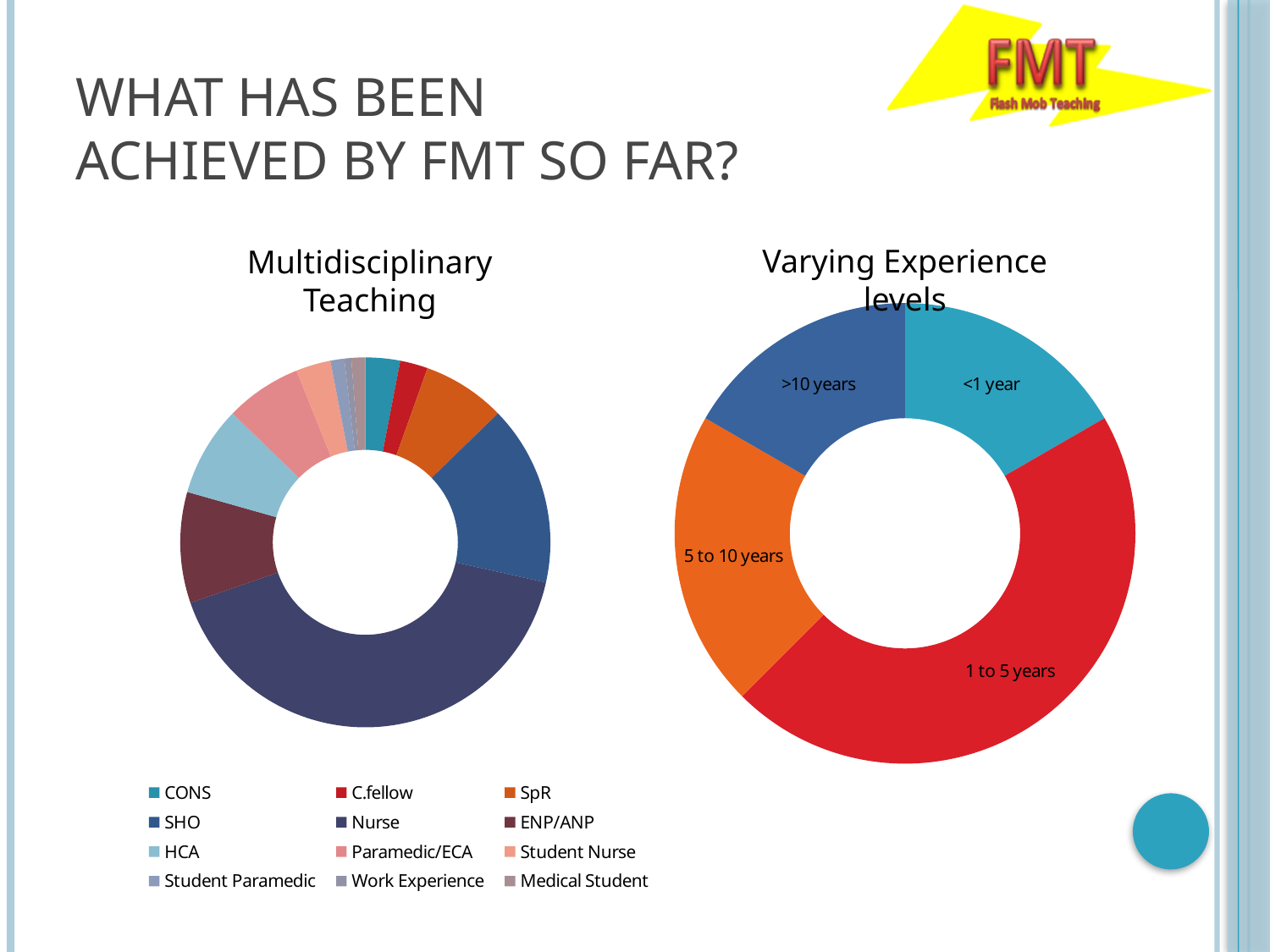
In the "Multidisciplinary Teaching" chart, which is larger: Nurse or SHO? Nurse In the "Varying Experience levels" chart, which is larger: 1 to 5 years or 5 to 10 years? 1 to 5 years In the "Varying Experience levels" chart, which category has the largest share? 1 to 5 years In the "Multidisciplinary Teaching" chart, how many entries does the legend list? 12 In the "Multidisciplinary Teaching" chart, which category has the largest share? Nurse What kind of chart is the "Varying Experience levels" chart? Doughnut chart In the "Varying Experience levels" chart, which is larger: 5 to 10 years or <1 year? 5 to 10 years In the "Varying Experience levels" chart, what colour is the 1 to 5 years segment? Red What kind of chart is the "Multidisciplinary Teaching" chart? Doughnut chart What is the title of the chart on the right of the slide? Varying Experience levels In the "Varying Experience levels" chart, how many categories are shown? 4